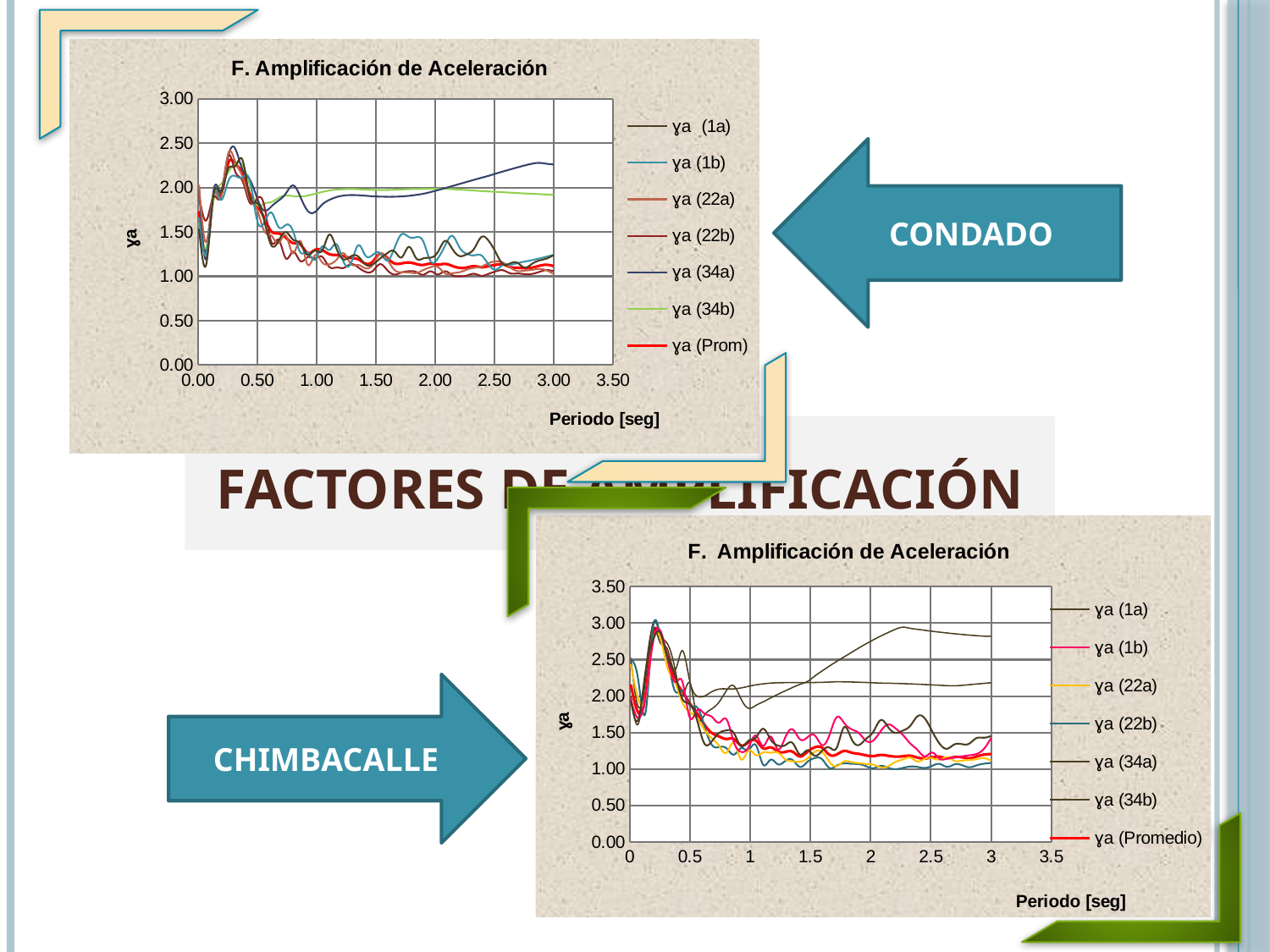
In the CHIMBACALLE chart (bottom right), is the value of γa (Promedio) at a period of 3 greater or less than 1.50? less In the CONDADO chart (top left), does the γa (34a) series rise or fall between periods 1.00 and 3.00? rise What kind of chart is the CONDADO chart (top left)? line chart What is the x-axis label of the CHIMBACALLE chart (bottom right)? Periodo [seg] In the CONDADO chart (top left), is the value of γa (Prom) at a period of 3.00 greater or less than 1.50? less In the CHIMBACALLE chart (bottom right), does the γa (Promedio) series rise or fall between periods 0.5 and 1.5? fall In the CONDADO chart (top left), is the value of γa (34a) at a period of 3.00 greater or less than 2.00? greater How many series does the legend of the CHIMBACALLE chart (bottom right) list? 7 What is the title of the CONDADO chart (top left)? F. Amplificación de Aceleración How many series does the legend of the CONDADO chart (top left) list? 7 What kind of chart is the CHIMBACALLE chart (bottom right)? line chart